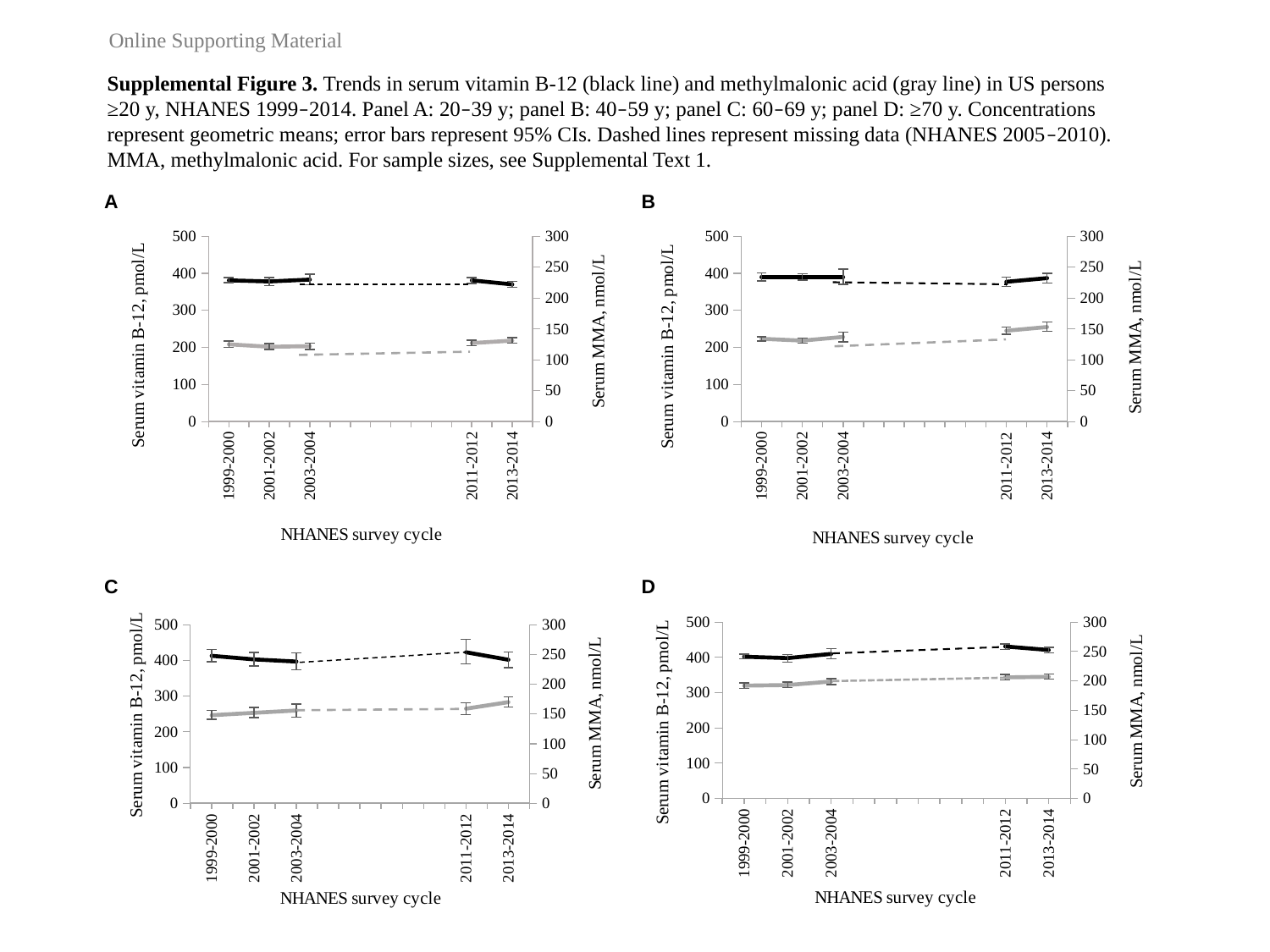
In panel A, is the serum vitamin B-12 value (black line) for 1999-2000 greater or less than 300 pmol/L? greater What is the x-axis title shown under panel C? NHANES survey cycle In panel B, how many lines (series) are plotted? 2 What is the title of the right-hand y axis in panel D? Serum MMA, nmol/L In panel C, does the serum MMA line (gray) rise or fall from 1999-2000 to 2013-2014? rise In panel D, is the serum vitamin B-12 value (black line) for 2011-2012 greater or less than 400 pmol/L? greater In panel A, is the serum MMA value (gray line) for 1999-2000 greater or less than 150 nmol/L? less In panel A, how many NHANES survey cycles are labeled on the x axis? 5 What kind of chart is panel A? line chart